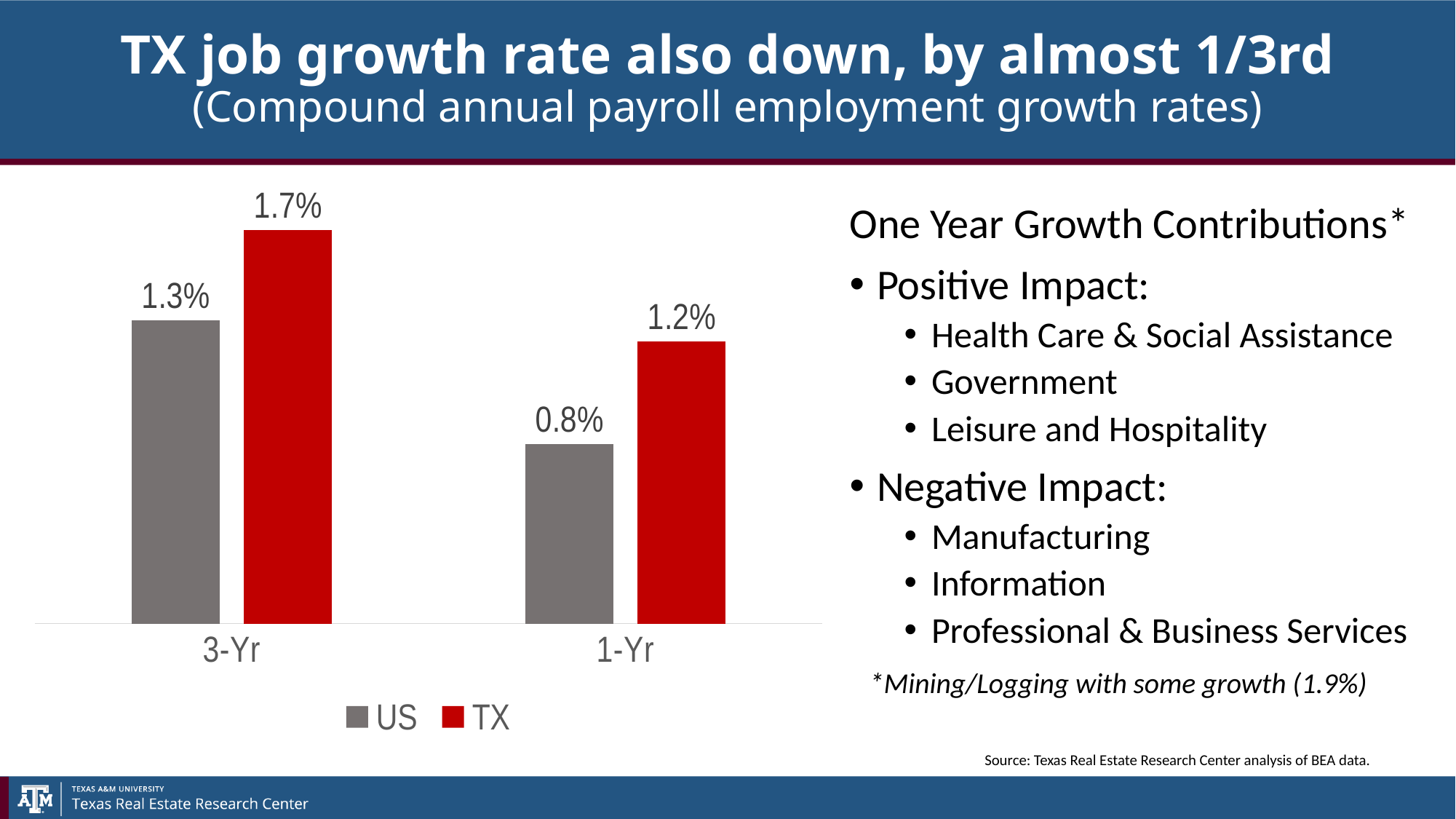
How many series does the legend list? 2 Which bar has the highest value on the chart? TX 3-Yr How many categories are shown on the x axis? 2 What is the difference between the TX 3-Yr and TX 1-Yr values? 0.5% Which is larger for 1-Yr, US or TX? TX What kind of chart is shown on the slide? Bar chart What is the TX value for 1-Yr? 1.2% What is the difference between the TX and US values for 3-Yr? 0.4% What is the US value for 3-Yr? 1.3% Which bar has the lowest value on the chart? US 1-Yr What is the TX value for 3-Yr? 1.7% What is the US value for 1-Yr? 0.8%